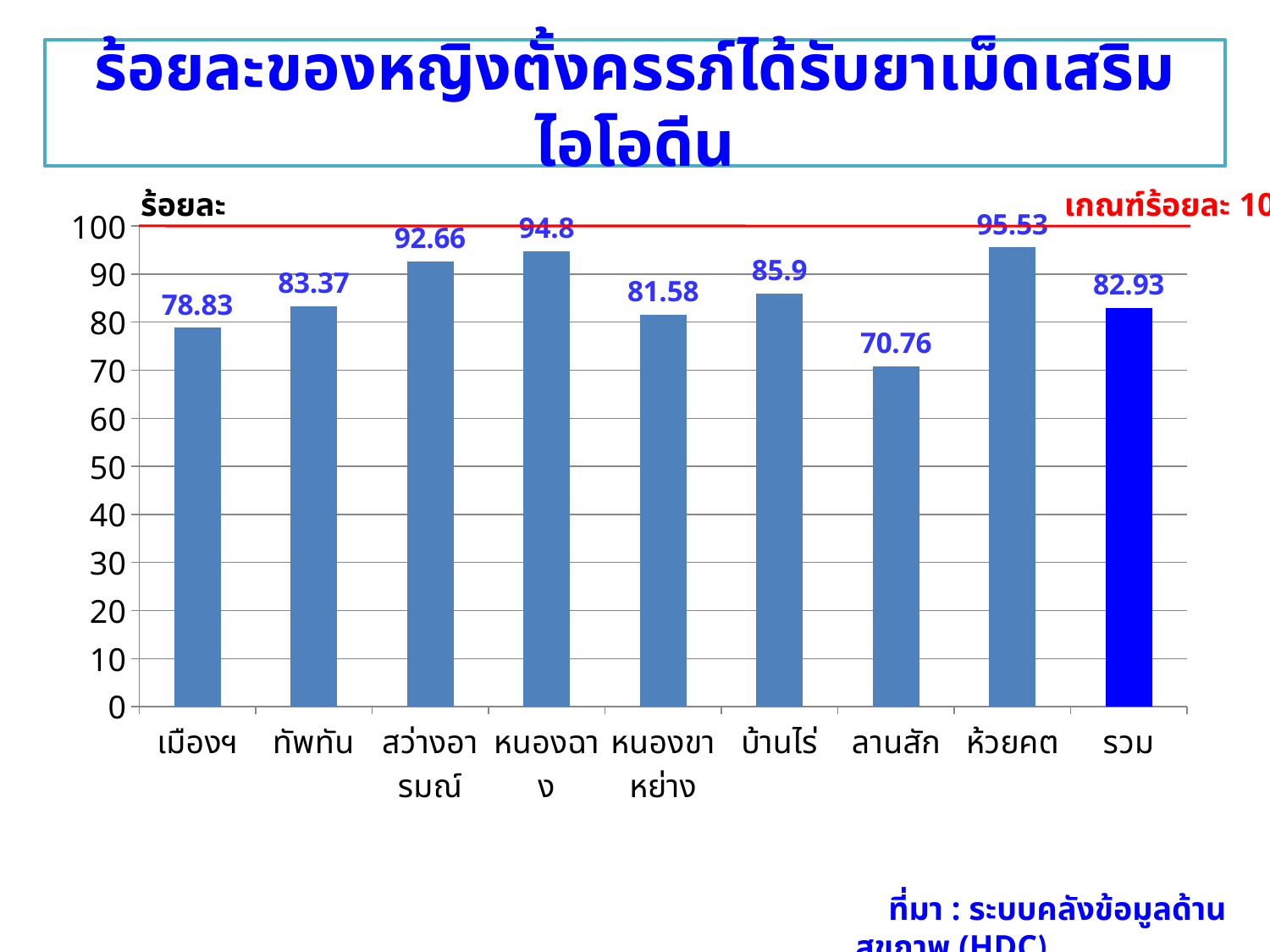
What is the difference between the values for ห้วยคต and ลานสัก? 24.77 What is the difference between the values for สว่างอารมณ์ and ทัพทัน? 9.29 Which bar is drawn in a different (darker blue) colour from the others? รวม Which category has the highest value? ห้วยคต What is the value for ลานสัก? 70.76 What is the value for เมืองฯ? 78.83 Which category has the lowest value? ลานสัก What kind of chart is shown on the slide? bar chart What is the value for หนองฉาง? 94.8 How many bars are shown in the chart? 9 Which is larger, the value for บ้านไร่ or the value for หนองขาหย่าง? บ้านไร่ What is the value for the รวม bar? 82.93